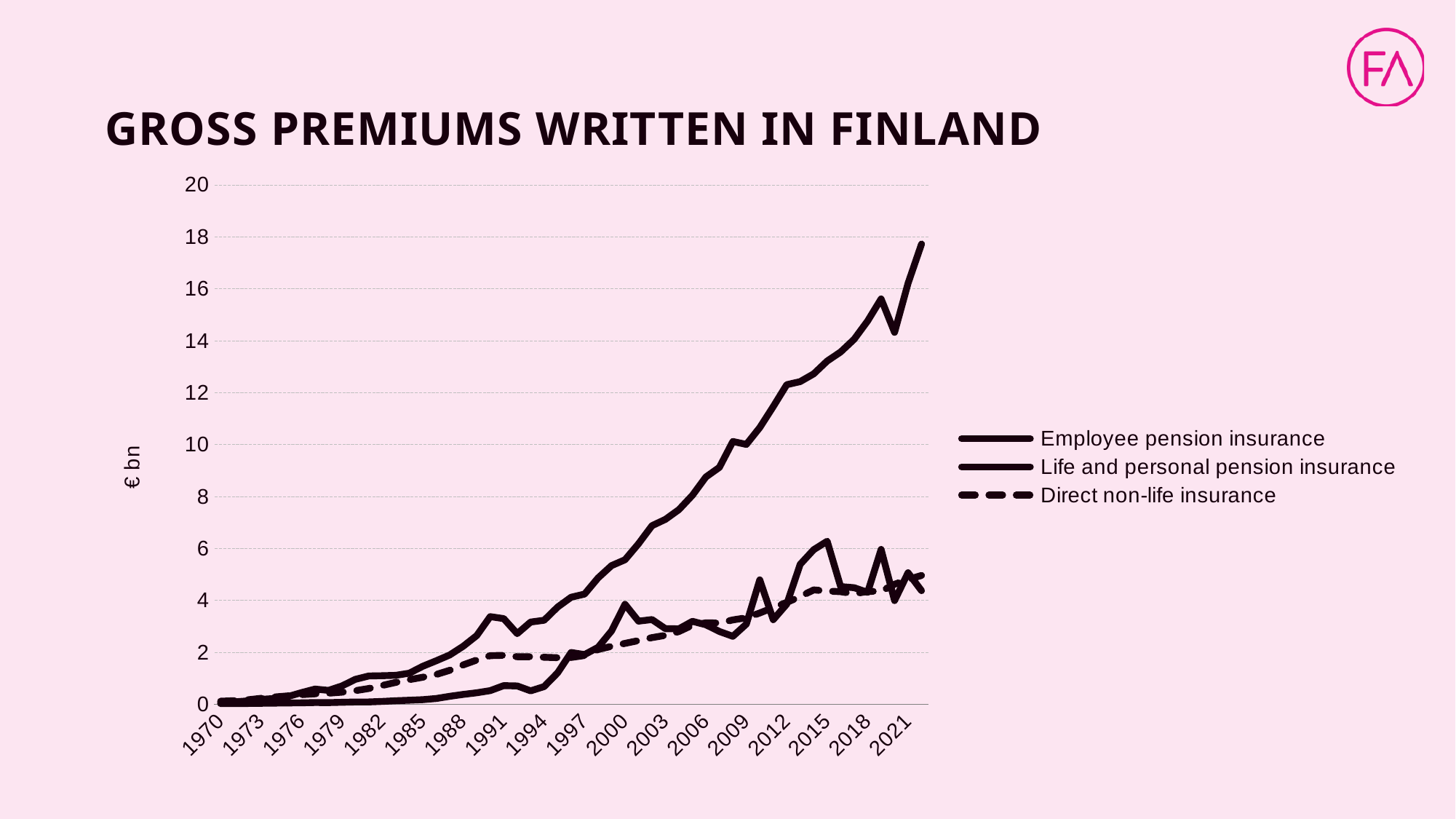
How many series does the legend list? 3 Is the value for Employee pension insurance in 2012 greater or less than 10? greater Is the value for Employee pension insurance in 2018 greater or less than 14? greater What kind of chart is shown on the slide? line chart Which series has the highest value in 2021? Employee pension insurance Does the Direct non-life insurance line generally rise or fall from 1970 to 2021? rise Does the Employee pension insurance line generally rise or fall from 1970 to 2021? rise Is the value for Direct non-life insurance in 2021 greater or less than 6? less What unit is shown on the vertical axis label? € bn What is the title of the chart? GROSS PREMIUMS WRITTEN IN FINLAND In 2021, which is larger: Employee pension insurance or Direct non-life insurance? Employee pension insurance